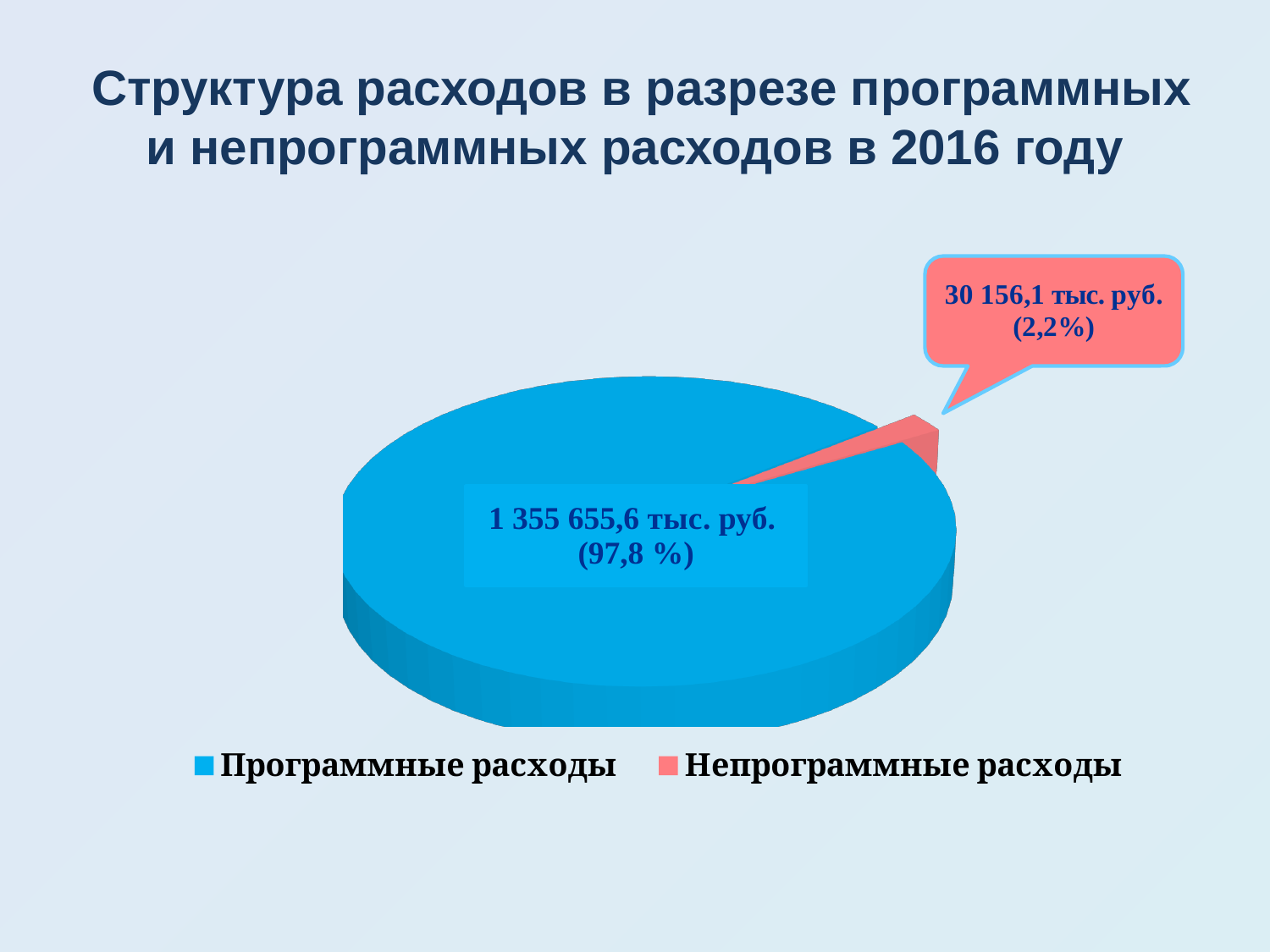
What is the value for Непрограммные расходы? 30 156,1 тыс. руб. How many entries does the legend list? 2 What is the value for Программные расходы? 1 355 655,6 тыс. руб. What kind of chart is shown on the slide? Pie chart What share of the pie does Непрограммные расходы represent? 2,2% What colour is the slice for Непрограммные расходы? Red How many categories does the pie chart show? 2 Which category has the smallest slice of the pie? Непрограммные расходы What is the title of the slide? Структура расходов в разрезе программных и непрограммных расходов в 2016 году What share of the pie does Программные расходы represent? 97,8 % Which category has the largest slice of the pie? Программные расходы Which is larger, Программные расходы or Непрограммные расходы? Программные расходы